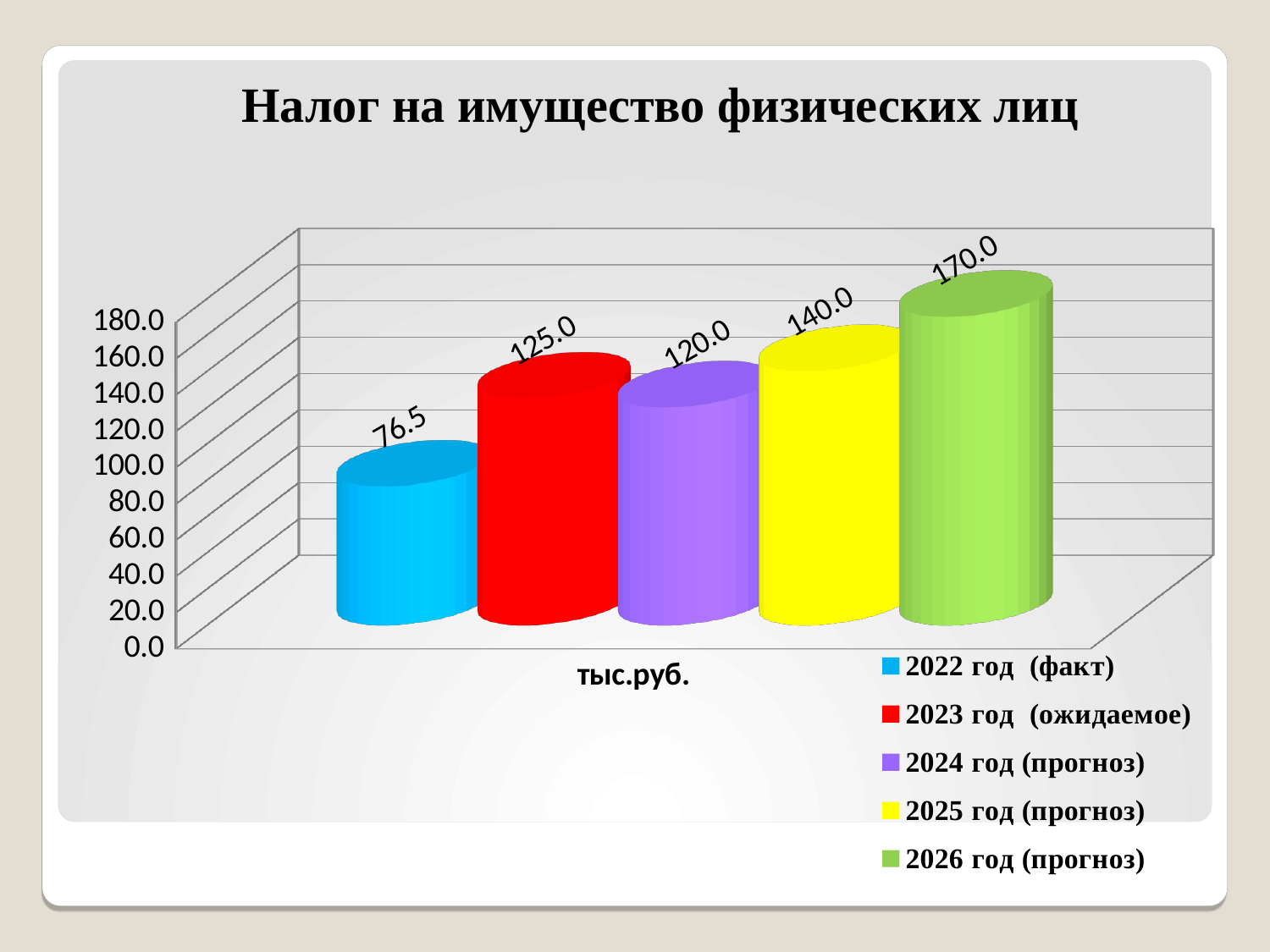
What is the value for 2024 год (прогноз)? 120.0 Which is larger, the value for 2023 год (ожидаемое) or 2024 год (прогноз)? 2023 год (ожидаемое) What is the difference between the values for 2026 год (прогноз) and 2025 год (прогноз)? 30.0 Which year has the highest value? 2026 год (прогноз) Which year has the lowest value? 2022 год (факт) What is the value for 2026 год (прогноз)? 170.0 What kind of chart is shown on the slide? Bar chart What unit is shown below the chart's bars? тыс.руб. What is the value for 2022 год (факт)? 76.5 What is the title of the chart? Налог на имущество физических лиц What is the value for 2023 год (ожидаемое)? 125.0 How many series does the legend list? 5